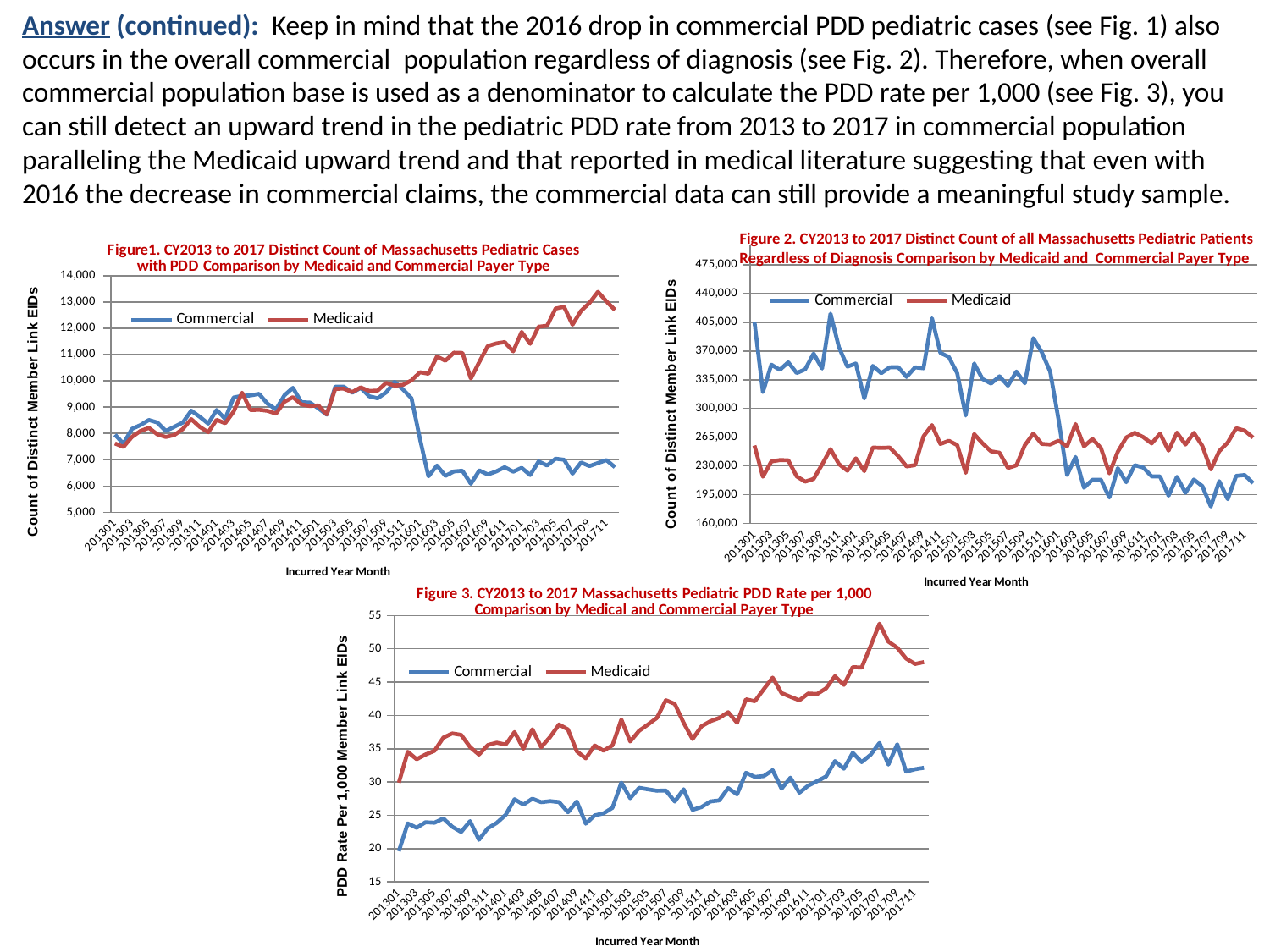
What kind of chart is Figure 1? line chart In Figure 2, is the Commercial value at 201707 greater or less than 195,000? less In Figure 3, does the Medicaid series overall rise or fall from 201301 to 201711? rise In Figure 3, is the Medicaid value at 201707 greater or less than 50? greater What is the y-axis title of Figure 3? PDD Rate Per 1,000 Member Link EIDs In Figure 1, is the Commercial value at 201603 greater or less than 7,000? less In Figure 2, does the Commercial series overall rise or fall from 201301 to 201711? fall How many series does the legend of Figure 3 list? 2 In Figure 1, at 201711, which series has the larger value, Commercial or Medicaid? Medicaid